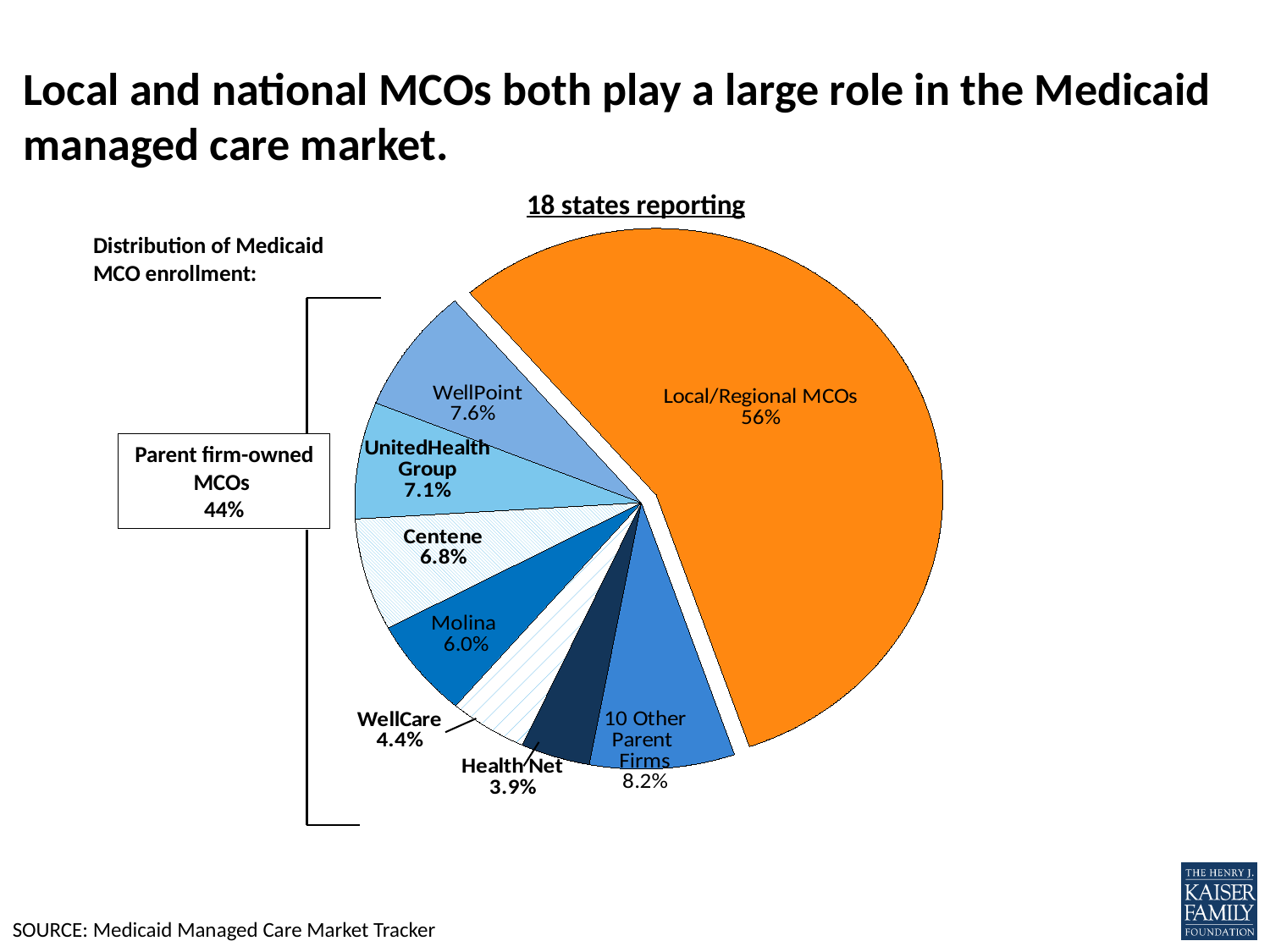
How many slices does the pie chart have? 8 Which has a larger share of enrollment, UnitedHealth Group or Molina? UnitedHealth Group What share of Medicaid MCO enrollment is held by Local/Regional MCOs? 56% What is the combined share of all parent firm-owned MCOs, as shown on the slide? 44% What share of Medicaid MCO enrollment is held by Centene? 6.8% Which slice of the pie is the largest? Local/Regional MCOs What share of Medicaid MCO enrollment is held by WellPoint? 7.6% What kind of chart is shown on the slide? pie chart What is the difference in share between WellPoint and WellCare? 3.2% Which named parent firm has the smallest share of Medicaid MCO enrollment? Health Net What share of Medicaid MCO enrollment is held by Health Net? 3.9% What share of Medicaid MCO enrollment is held by the 10 Other Parent Firms? 8.2%